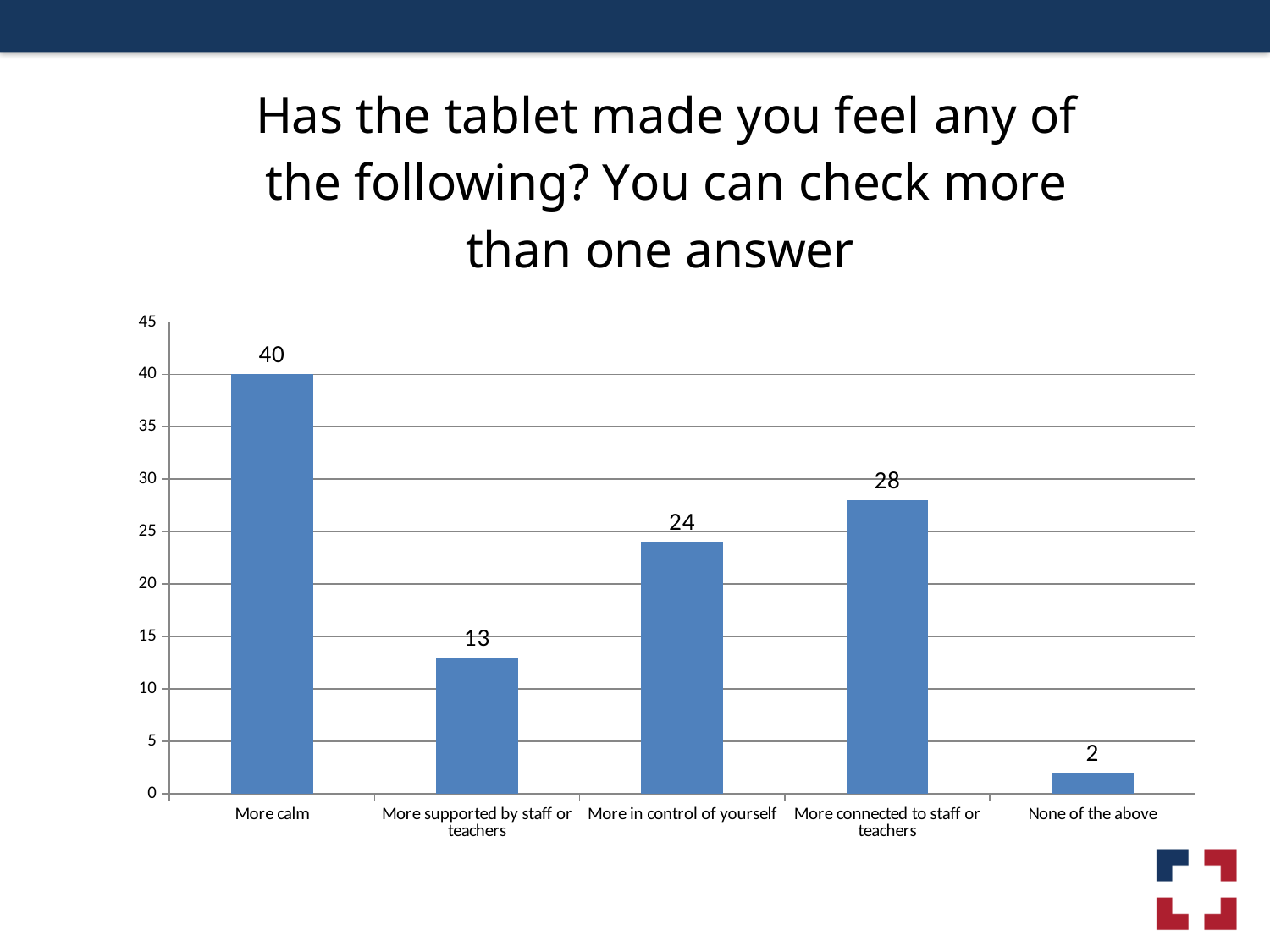
Which category has the lowest value? None of the above What kind of chart is shown on the slide? Bar chart What is the title of the slide above the chart? Has the tablet made you feel any of the following? You can check more than one answer What is the difference between the values for "More calm" and "More connected to staff or teachers"? 12 Is the value for "More connected to staff or teachers" greater or less than 25? greater What is the value for "None of the above"? 2 What is the value for "More calm"? 40 What is the value for "More supported by staff or teachers"? 13 Which category has the highest value? More calm Which is larger, the value for "More in control of yourself" or the value for "More supported by staff or teachers"? More in control of yourself What is the value for "More in control of yourself"? 24 How many categories are shown on the x axis? 5